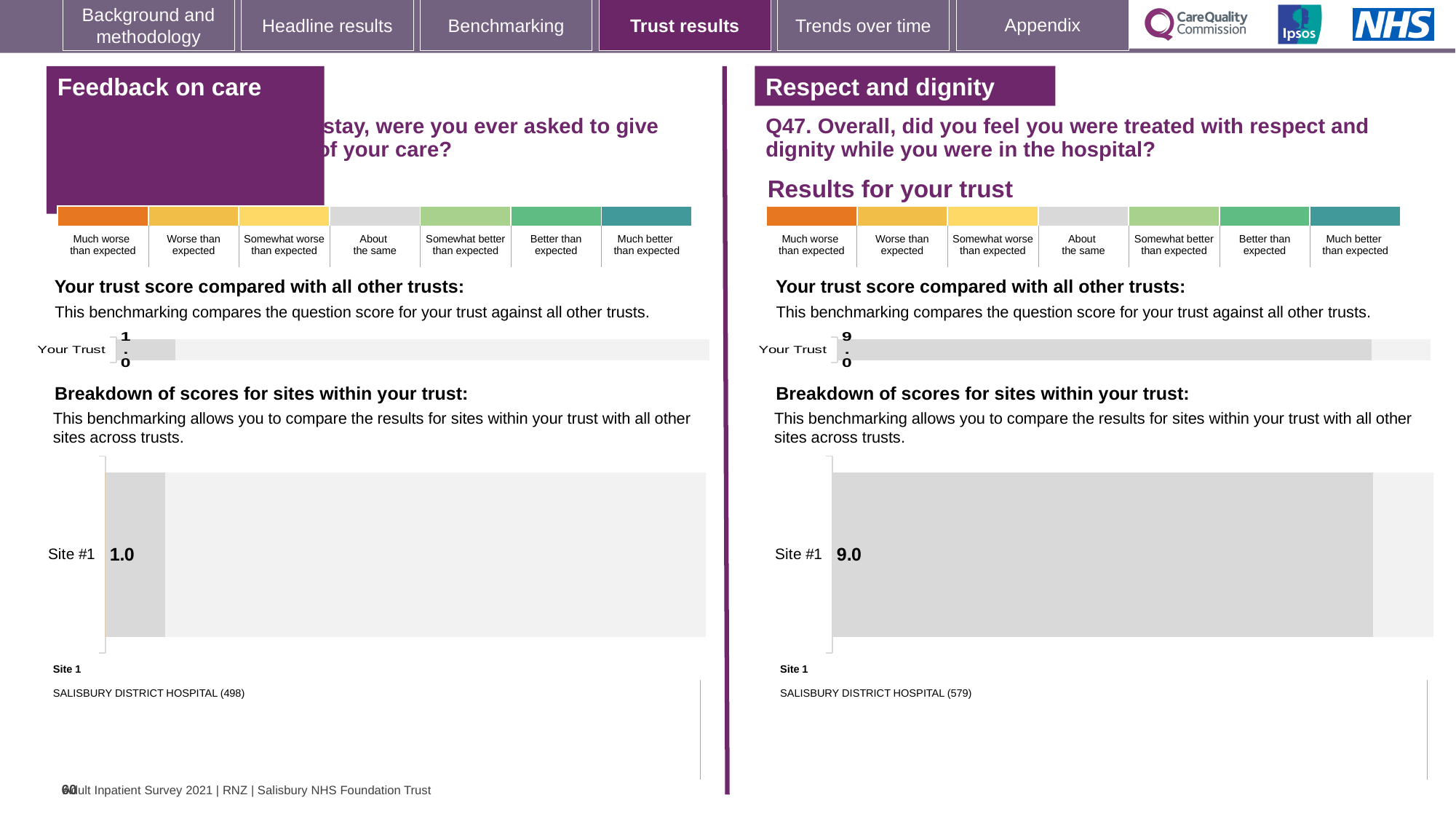
How many sites are shown in the 'Breakdown of scores for sites within your trust' chart on the left (Feedback on care)? 1 In the 'Breakdown of scores for sites within your trust' chart on the left (Feedback on care), what is the value for Site #1? 1.0 Which site name is listed as Site 1 under the 'Feedback on care' breakdown chart? SALISBURY DISTRICT HOSPITAL (498) What is the difference between the Site #1 score in the 'Respect and dignity' breakdown chart and the Site #1 score in the 'Feedback on care' breakdown chart? 8.0 What type of chart is used to show the Your Trust score in the 'Feedback on care' section? Bar chart How many sites are shown in the 'Breakdown of scores for sites within your trust' chart on the right (Respect and dignity)? 1 What type of chart is used to show the Site #1 score in the 'Respect and dignity' section? Bar chart On the 'Respect and dignity' section, what is the score shown for Your Trust in the 'Your trust score compared with all other trusts' chart? 9.0 On the 'Feedback on care' section, what is the score shown for Your Trust in the 'Your trust score compared with all other trusts' chart? 1.0 Which is larger: the Your Trust score in the 'Feedback on care' chart or the Your Trust score in the 'Respect and dignity' chart? Respect and dignity In the 'Breakdown of scores for sites within your trust' chart on the right (Respect and dignity), what is the value for Site #1? 9.0 Which site name is listed as Site 1 under the 'Respect and dignity' breakdown chart? SALISBURY DISTRICT HOSPITAL (579)